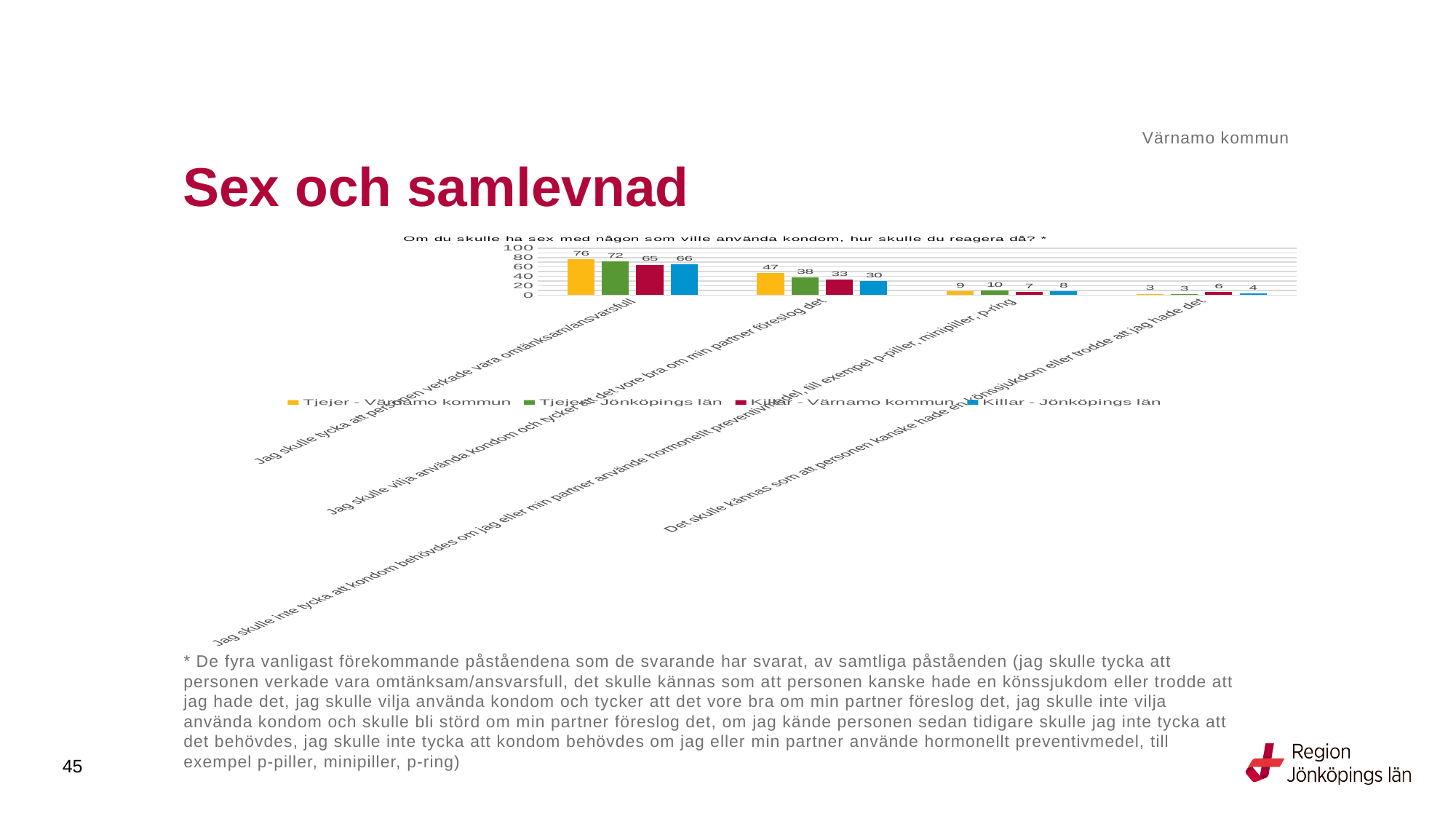
What kind of chart is shown on the slide? Bar chart For the statement "Jag skulle vilja använda kondom och tycker att det vore bra om min partner föreslog det", which is larger: Tjejer - Värnamo kommun or Tjejer - Jönköpings län? Tjejer - Värnamo kommun Which series has the lowest value for the statement "Jag skulle vilja använda kondom och tycker att det vore bra om min partner föreslog det"? Killar - Jönköpings län Which colour represents Killar - Jönköpings län in the legend? Blue How many series does the legend list? 4 What is the difference between Tjejer - Värnamo kommun and Killar - Värnamo kommun for the statement "Jag skulle tycka att personen verkade vara omtänksam/ansvarsfull"? 11 What is the value for Killar - Värnamo kommun for the statement "Det skulle kännas som att personen kanske hade en könssjukdom eller trodde att jag hade det"? 6 What is the value for Tjejer - Värnamo kommun for the statement "Jag skulle tycka att personen verkade vara omtänksam/ansvarsfull"? 76 What is the value for Killar - Jönköpings län for the statement "Jag skulle vilja använda kondom och tycker att det vore bra om min partner föreslog det"? 30 What is the value for Tjejer - Jönköpings län for the statement about not thinking a condom was needed if hormonal contraception was used? 10 Which series has the highest value for the statement "Jag skulle tycka att personen verkade vara omtänksam/ansvarsfull"? Tjejer - Värnamo kommun How many statements (categories) are shown on the x axis of the chart? 4